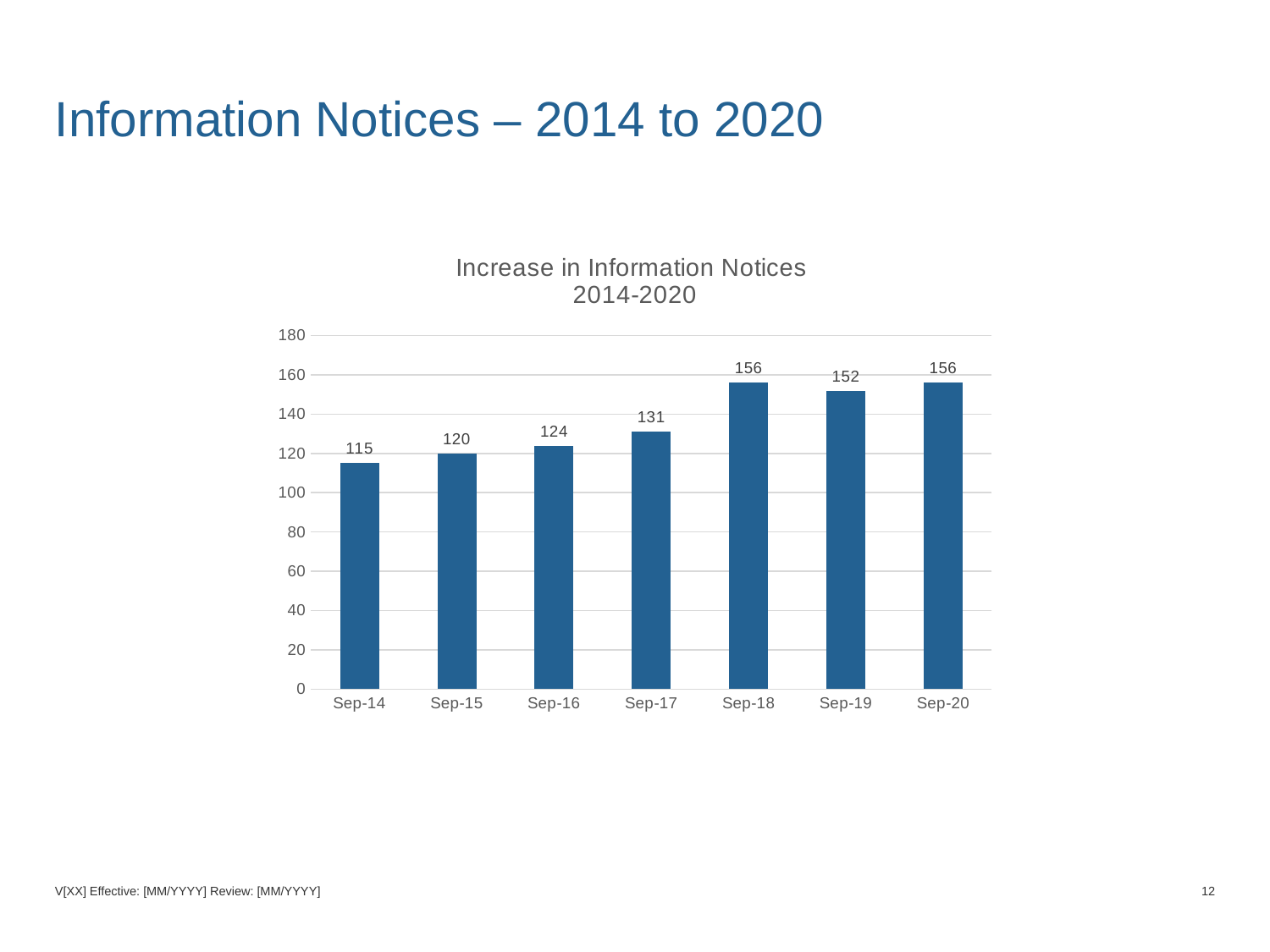
Which category has the lowest value? Sep-14 Is the value for Sep-15 greater or less than 140? less What is the title of the chart? Increase in Information Notices 2014-2020 How many categories are shown on the x axis? 7 What is the difference between the values for Sep-18 and Sep-19? 4 What is the value for Sep-19? 152 What kind of chart is shown? bar chart What is the value for Sep-14? 115 Which is larger, the value for Sep-16 or the value for Sep-17? Sep-17 What is the difference between the values for Sep-20 and Sep-14? 41 What is the value for Sep-17? 131 Do the values generally rise or fall from Sep-14 to Sep-18? rise